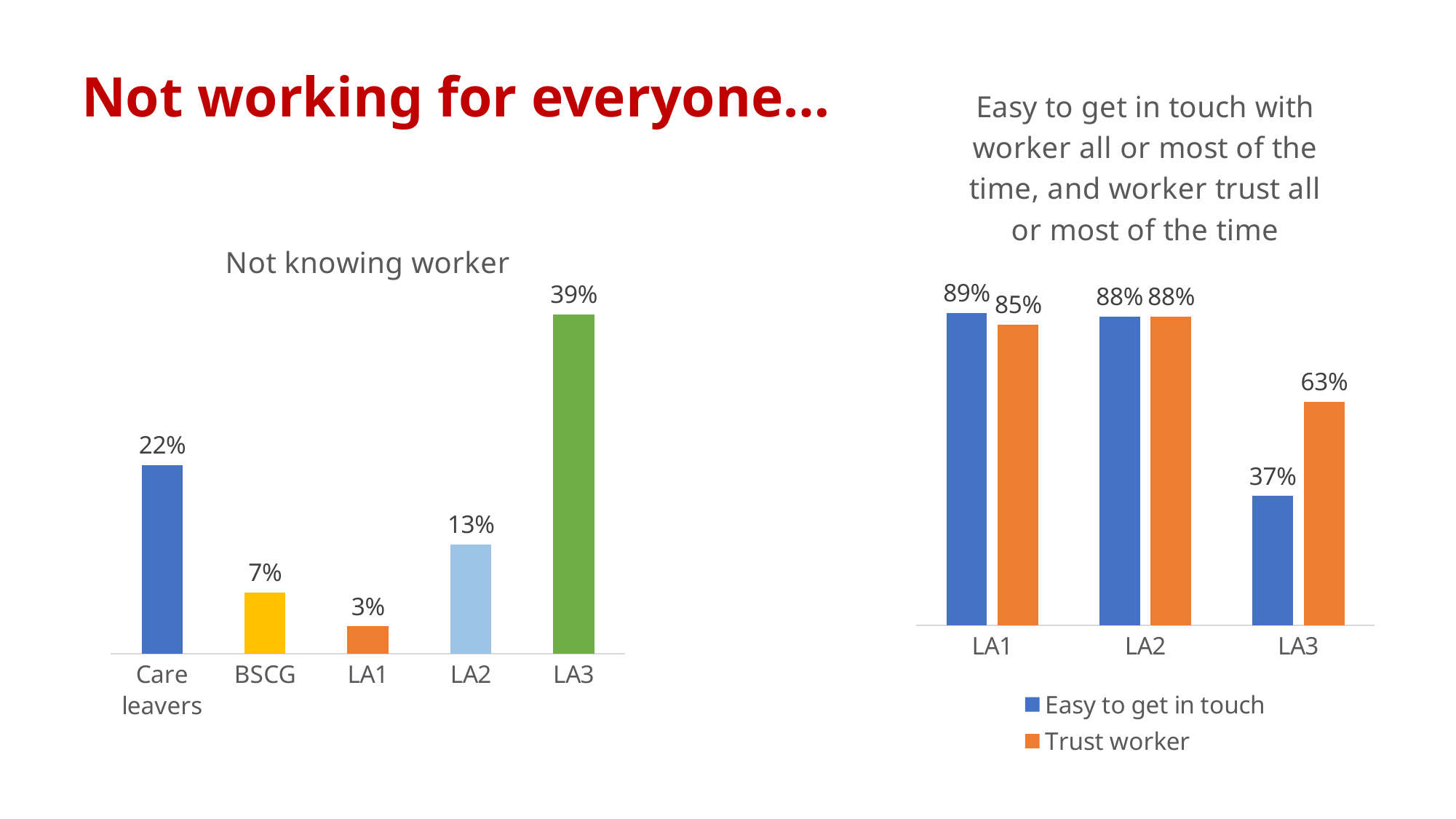
In the right-hand chart, which is larger for LA3: 'Easy to get in touch' or 'Trust worker'? Trust worker In the 'Not knowing worker' chart, what is the value for Care leavers? 22% In the 'Not knowing worker' chart, what is the value for LA3? 39% In the right-hand chart, what is the 'Trust worker' value for LA3? 63% In the 'Not knowing worker' chart, what is the difference between the values for LA2 and BSCG? 6% In the right-hand chart, how many series does the legend list? 2 In the right-hand chart, what is the difference between the 'Easy to get in touch' values for LA2 and LA3? 51% What kind of chart is the 'Not knowing worker' chart? Bar chart In the 'Not knowing worker' chart, which category has the highest value? LA3 In the 'Not knowing worker' chart, which category has the lowest value? LA1 In the right-hand chart, what is the 'Easy to get in touch' value for LA1? 89% In the 'Not knowing worker' chart, how many categories are shown? 5